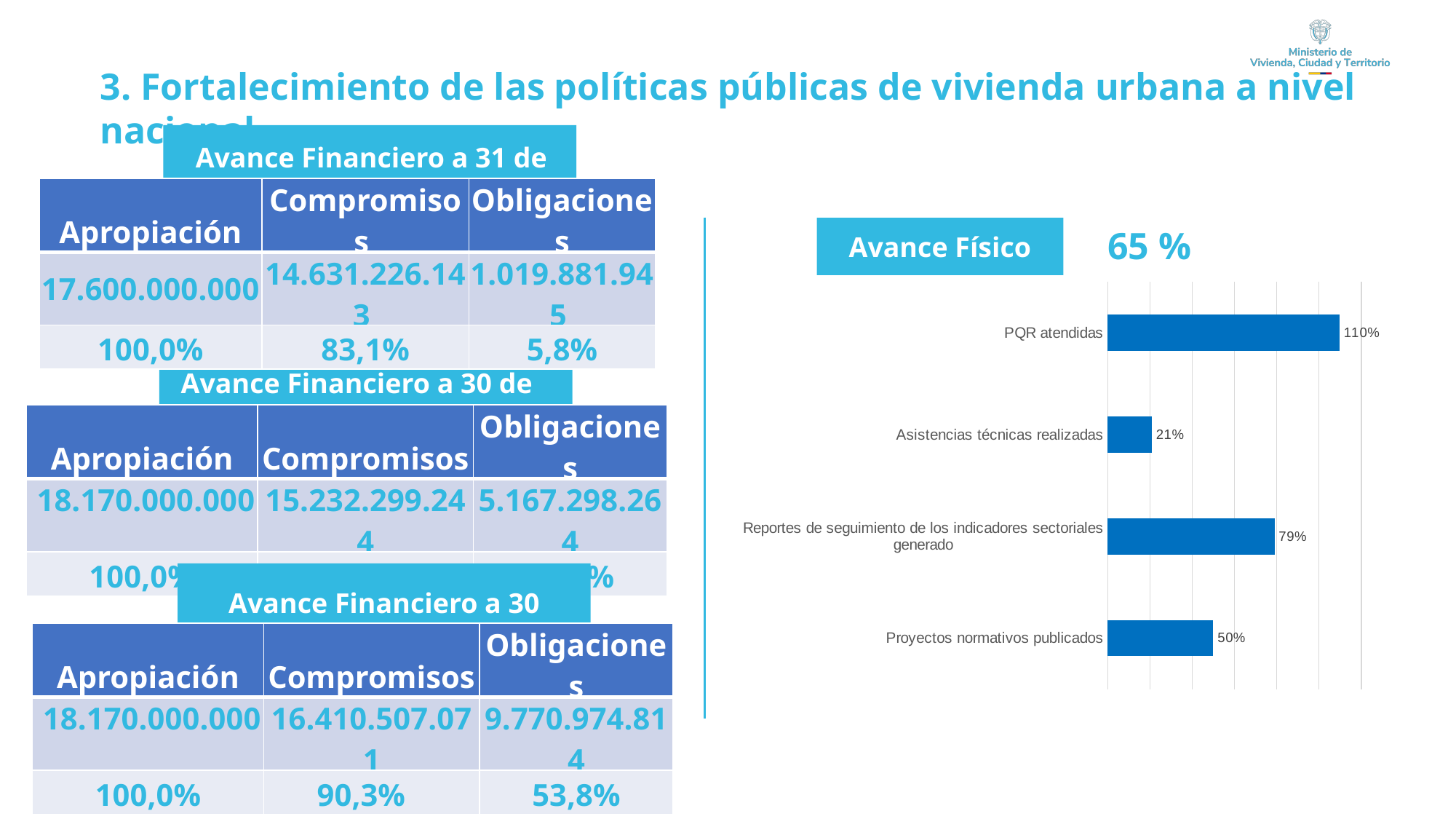
Which category has the lowest value? Asistencias técnicas realizadas What is the difference between the values for Reportes de seguimiento de los indicadores sectoriales generado and Asistencias técnicas realizadas? 58% What overall percentage is shown next to the 'Avance Físico' label above the chart? 65 % Which is larger, the value for Proyectos normativos publicados or the value for Asistencias técnicas realizadas? Proyectos normativos publicados What kind of chart is shown on the slide? bar chart Which category has the highest value? PQR atendidas What is the value for Reportes de seguimiento de los indicadores sectoriales generado? 79% What is the value for Proyectos normativos publicados? 50% What is the value for PQR atendidas? 110% What is the difference between the values for PQR atendidas and Proyectos normativos publicados? 60% What is the value for Asistencias técnicas realizadas? 21% How many categories are shown in the bar chart? 4